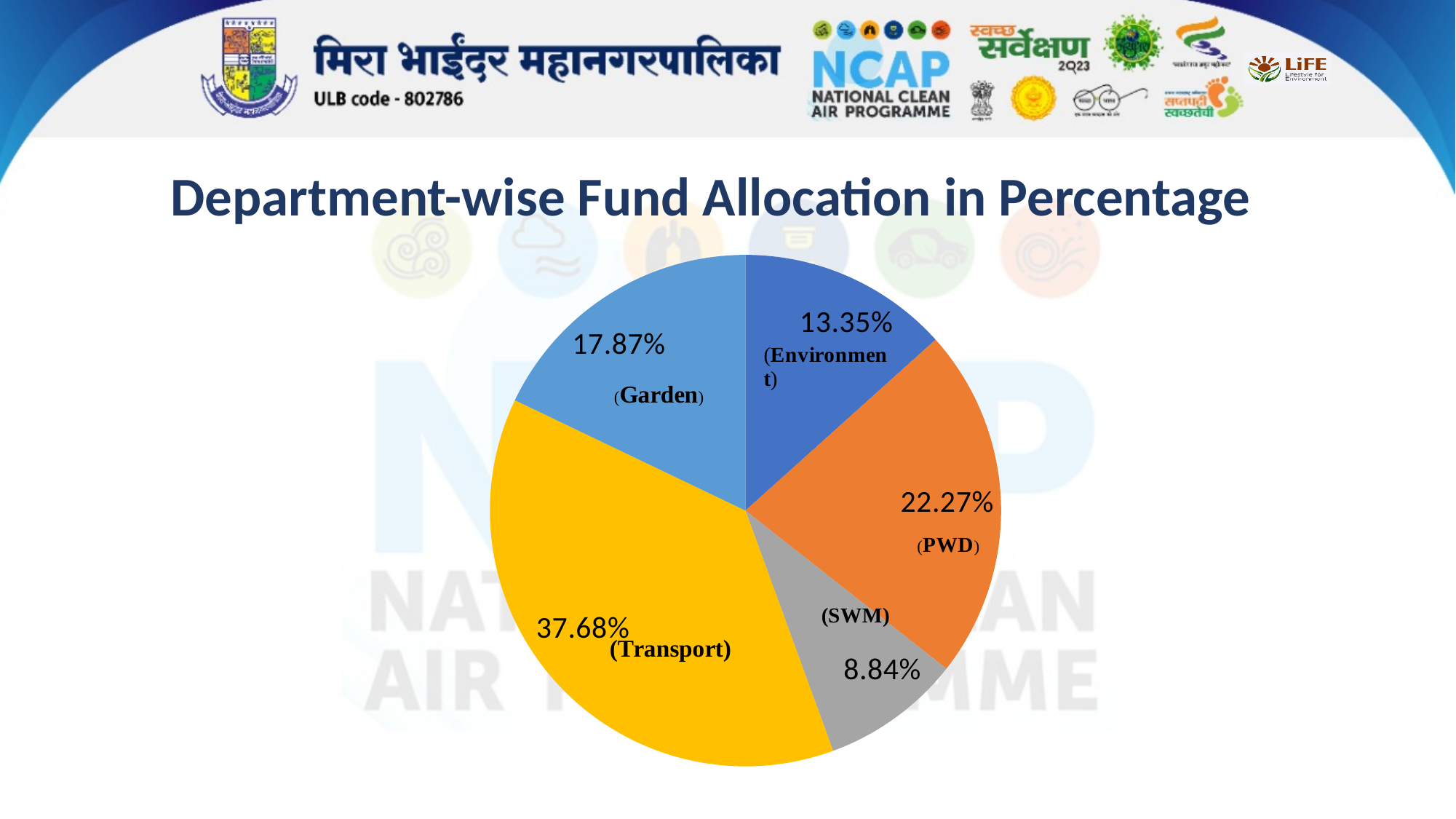
Which receives a larger share of funds, Garden or Environment? Garden What is the difference in percentage points between the Transport and PWD allocations? 15.41 Which department receives the smallest share of funds? SWM What is the title of the chart? Department-wise Fund Allocation in Percentage How many departments are shown in the pie chart? 5 What percentage of funds is allocated to Garden? 17.87% What percentage of funds is allocated to Transport? 37.68% What percentage of funds is allocated to SWM? 8.84% Which department receives the largest share of funds? Transport What percentage of funds is allocated to PWD? 22.27% What percentage of funds is allocated to Environment? 13.35% What type of chart is shown on the slide? pie chart